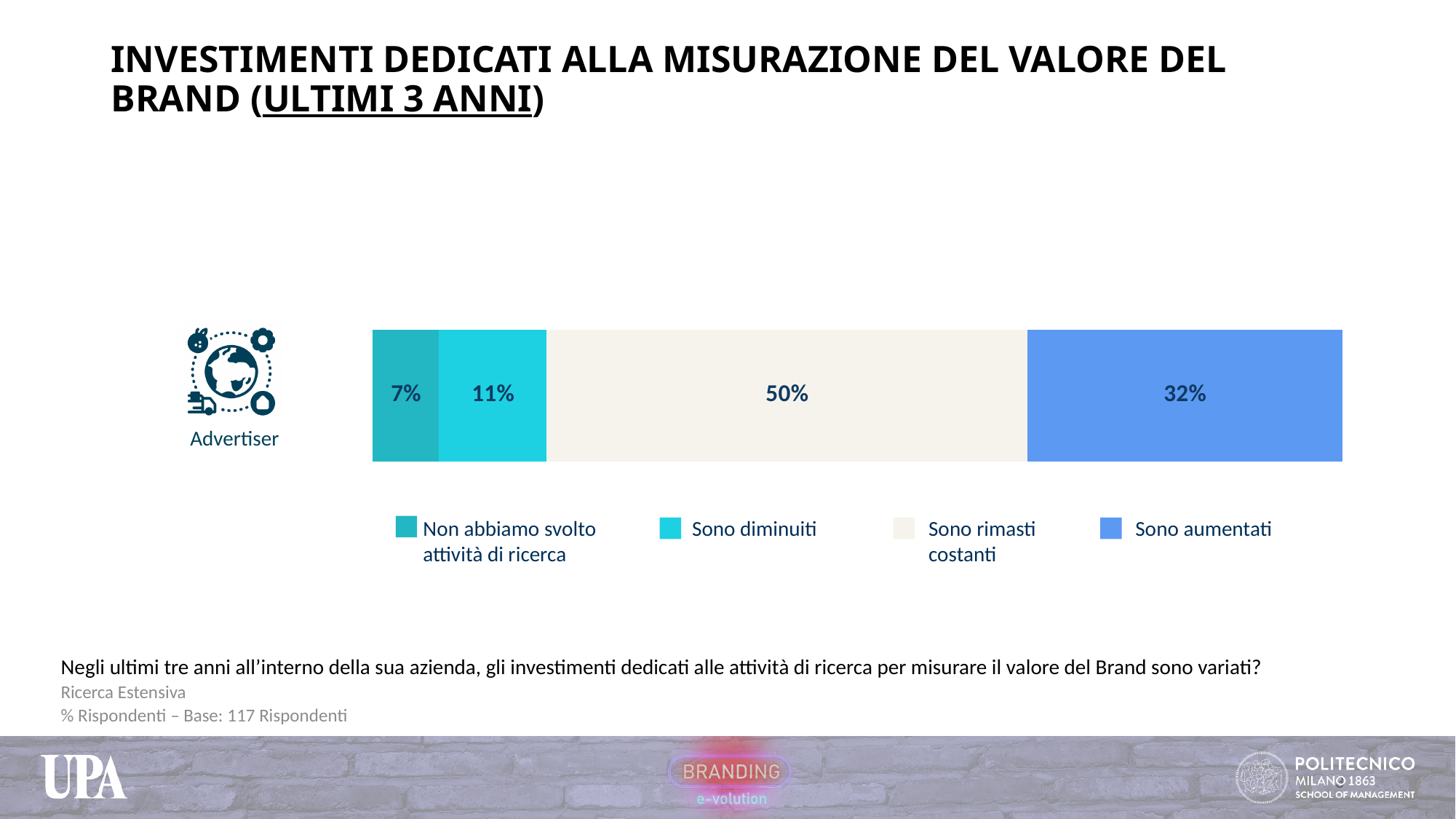
Which response has the smallest share in the Advertiser bar? Non abbiamo svolto attività di ricerca Which response has the largest share in the Advertiser bar? Sono rimasti costanti What is the difference between the 'Sono diminuiti' share and the 'Non abbiamo svolto attività di ricerca' share? 4% What percentage of Advertiser respondents said investments 'Sono rimasti costanti'? 50% What kind of chart is shown on the slide? Stacked bar chart What is the total of all segments in the Advertiser bar? 100% What percentage of Advertiser respondents said investments 'Sono diminuiti'? 11% What percentage of Advertiser respondents said investments 'Sono aumentati'? 32% What percentage of Advertiser respondents said 'Non abbiamo svolto attività di ricerca'? 7% What is the difference between the 'Sono rimasti costanti' share and the 'Sono aumentati' share? 18% How many series does the legend list? 4 Which is larger: the share for 'Sono aumentati' or the share for 'Sono diminuiti'? Sono aumentati